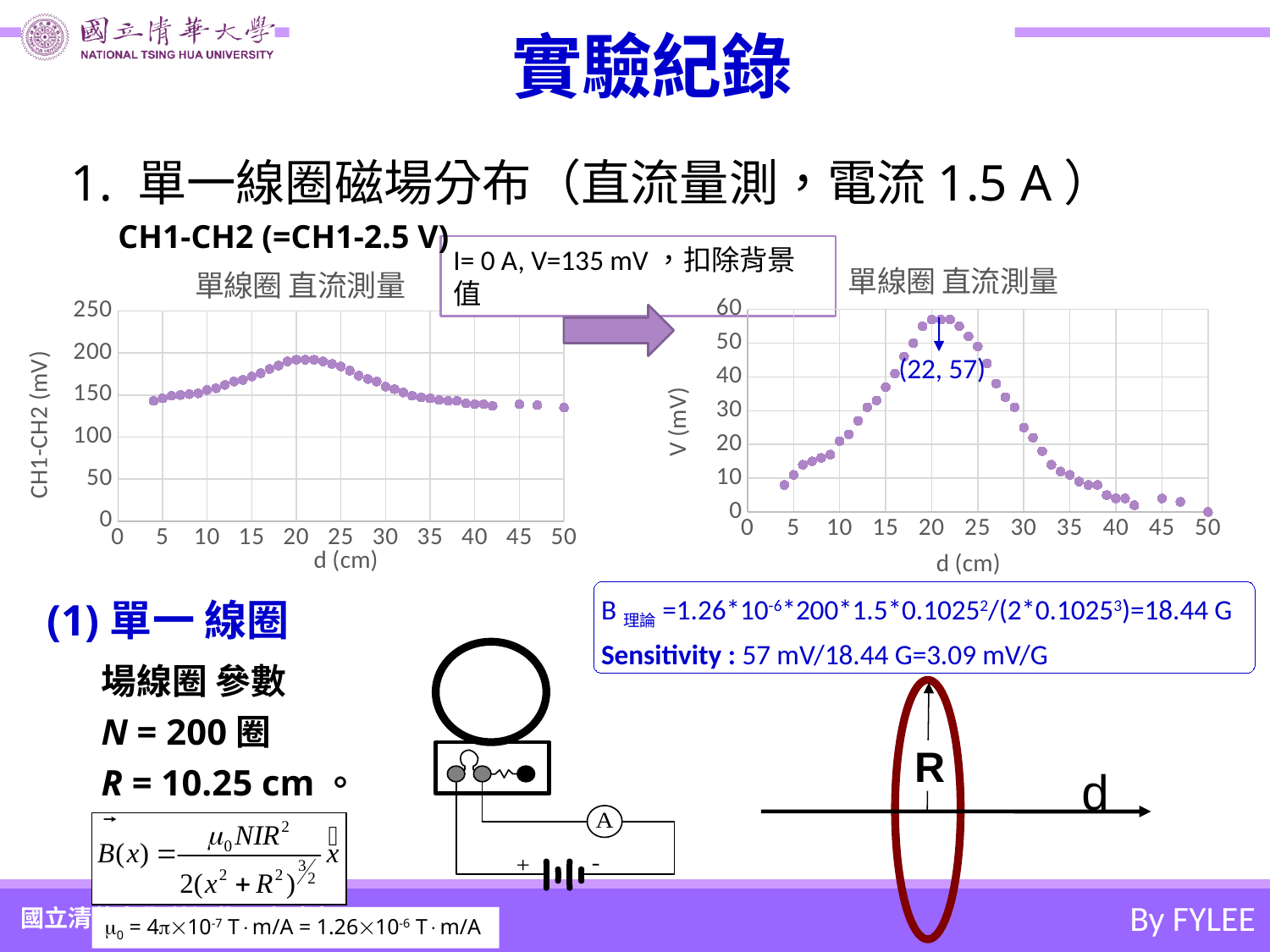
What kind of chart is the left chart titled 單線圈 直流測量? scatter chart On the right chart, is the V value at d = 5 cm greater or less than 20? less On the right chart, at what d (cm) does the labelled peak point occur? 22 On the left chart, is the CH1-CH2 value at d = 50 cm greater or less than 150? less On the left chart, is the value at d = 22 cm larger or smaller than the value at d = 45 cm? larger On the left chart, is the CH1-CH2 value at d = 22 cm greater or less than 150? greater What is the x-axis label of the right chart? d (cm) What is the y-axis label of the left chart? CH1-CH2 (mV) On the right chart, do the values rise or fall as d increases from 25 cm to 50 cm? fall On the right chart, what is the V (mV) value at the labelled point where d = 22 cm? 57 On the right chart, do the values rise or fall as d increases from 5 cm to 20 cm? rise